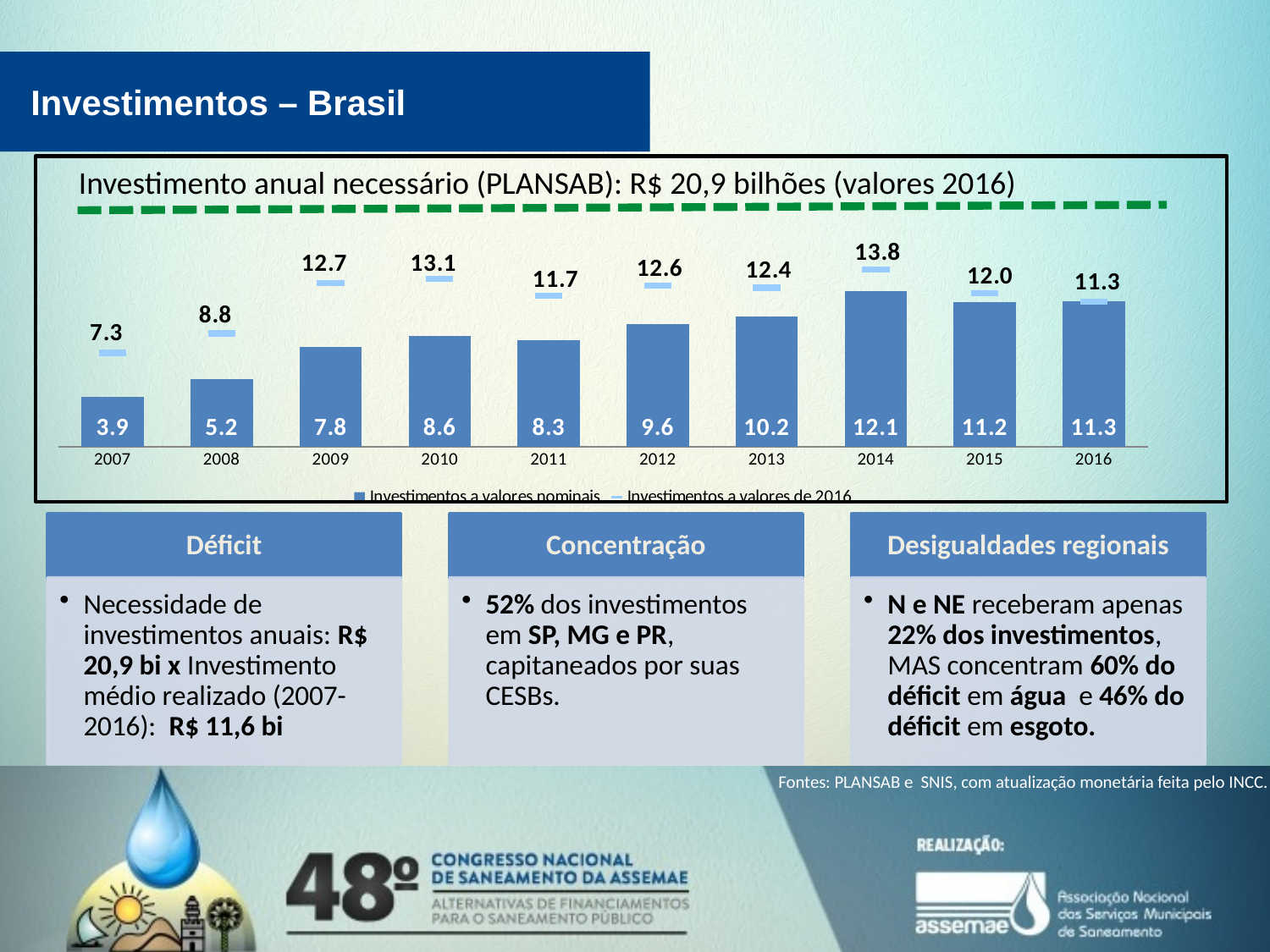
How many series does the chart legend list? 2 What kind of chart is used to show 'Investimentos a valores nominais'? bar chart Which year has the lowest value for 'Investimentos a valores de 2016'? 2007 What is the difference between the 'Investimentos a valores de 2016' value and the 'Investimentos a valores nominais' value for 2009? 4.9 What is the value of 'Investimentos a valores de 2016' for 2014? 13.8 What annual investment requirement (PLANSAB) is stated above the chart? R$ 20,9 bilhões Which year has the highest value for 'Investimentos a valores nominais'? 2014 Do the 'Investimentos a valores nominais' values generally rise or fall from 2007 to 2014? rise How many years are shown on the x axis of the chart? 10 What is the value of 'Investimentos a valores nominais' for 2013? 10.2 What is the value of 'Investimentos a valores nominais' for 2007? 3.9 Which is larger for 2011: 'Investimentos a valores nominais' or 'Investimentos a valores de 2016'? Investimentos a valores de 2016